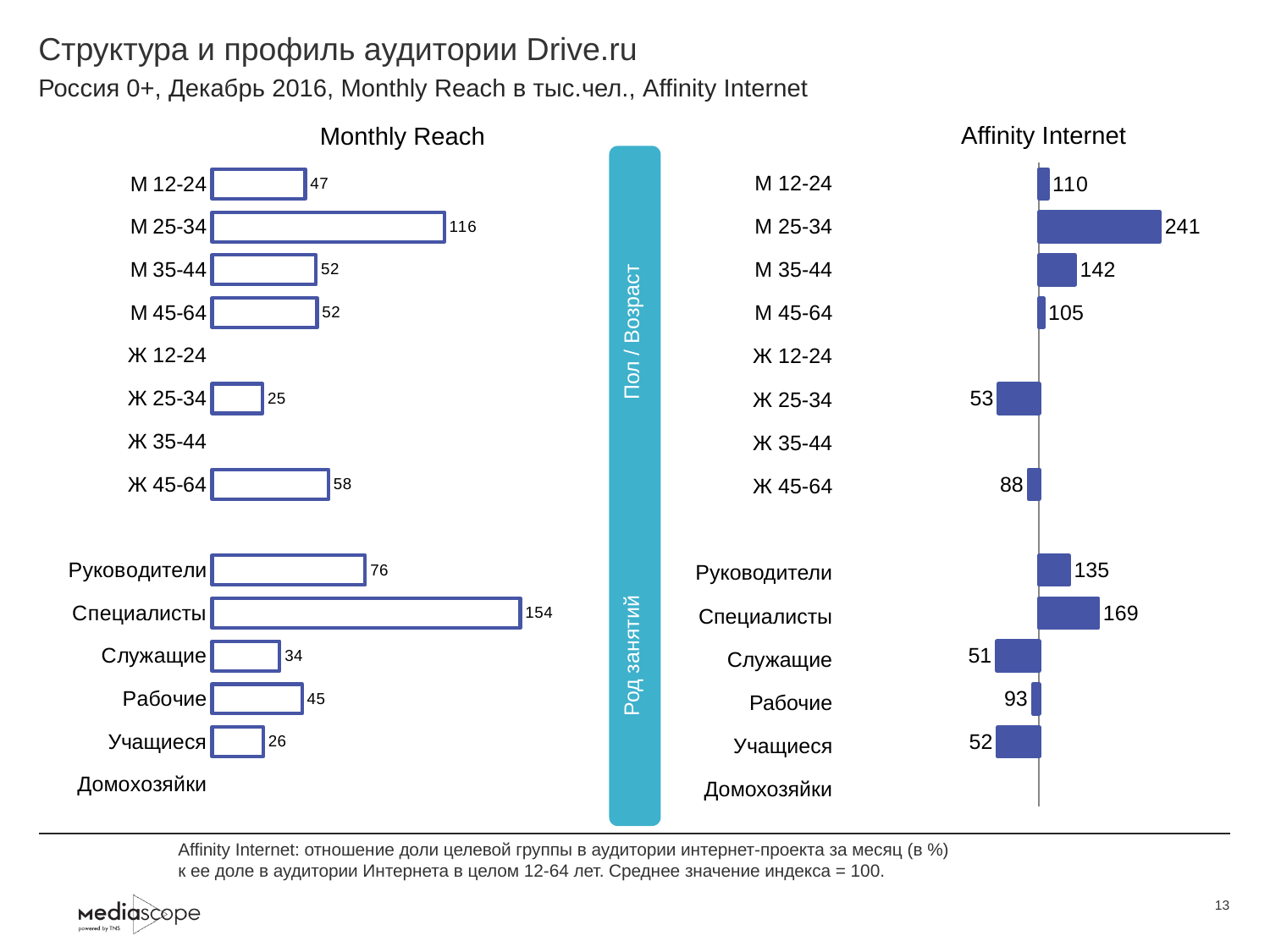
In the Affinity Internet chart, what is the value for Учащиеся? 52 In the Affinity Internet chart, what is the value for М 35-44? 142 In the Affinity Internet chart, what is the difference between Специалисты and Руководители? 34 What type of chart is the Affinity Internet chart? Bar chart In the Affinity Internet chart, which is larger, Ж 25-34 or Ж 45-64? Ж 45-64 In the Monthly Reach chart, what is the value for Специалисты? 154 In the Affinity Internet chart, which category has the highest value? М 25-34 In the Monthly Reach chart, which category has the lowest labelled value? Ж 25-34 What is the title of the chart on the left side of the slide? Monthly Reach In the Monthly Reach chart, what is the difference between Руководители and Служащие? 42 In the Monthly Reach chart, which is larger, Рабочие or Учащиеся? Рабочие In the Monthly Reach chart, what is the value for М 25-34? 116